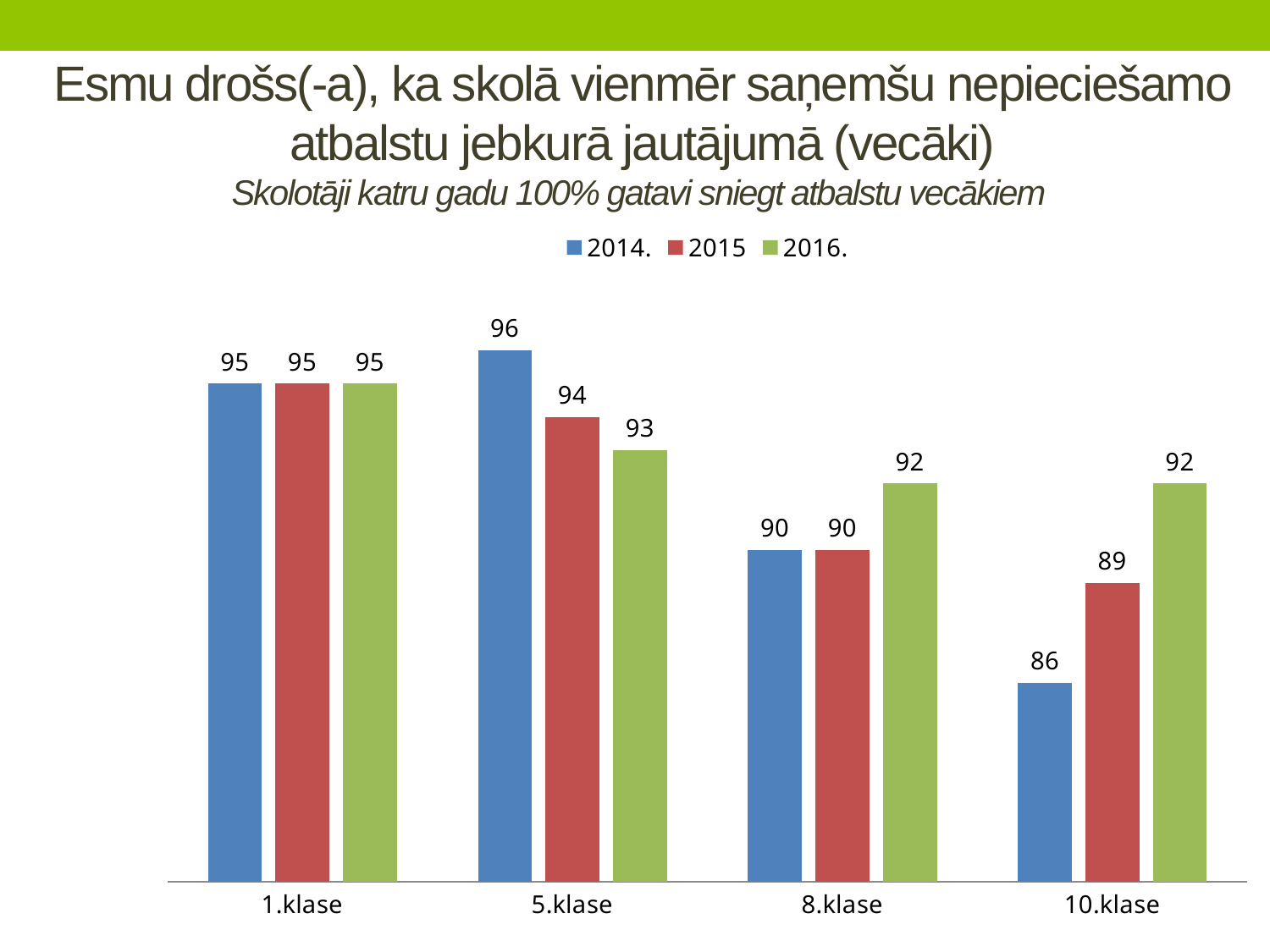
How many series does the legend list? 3 How many categories are shown on the x axis? 4 Which colour represents the 2016. series in the legend? green Which category has the lowest value in the 2014. series? 10.klase What is the difference between the 2016. and 2014. values for 10.klase? 6 Do the values in the 2014. series rise or fall from 5.klase to 10.klase? fall What kind of chart is shown on the slide? bar chart Which category has the highest value in the 2014. series? 5.klase What is the value for 5.klase in the 2014. series? 96 What is the value for 10.klase in the 2015 series? 89 What is the value for 8.klase in the 2016. series? 92 Which is larger for 5.klase: the 2015 value or the 2016. value? 2015